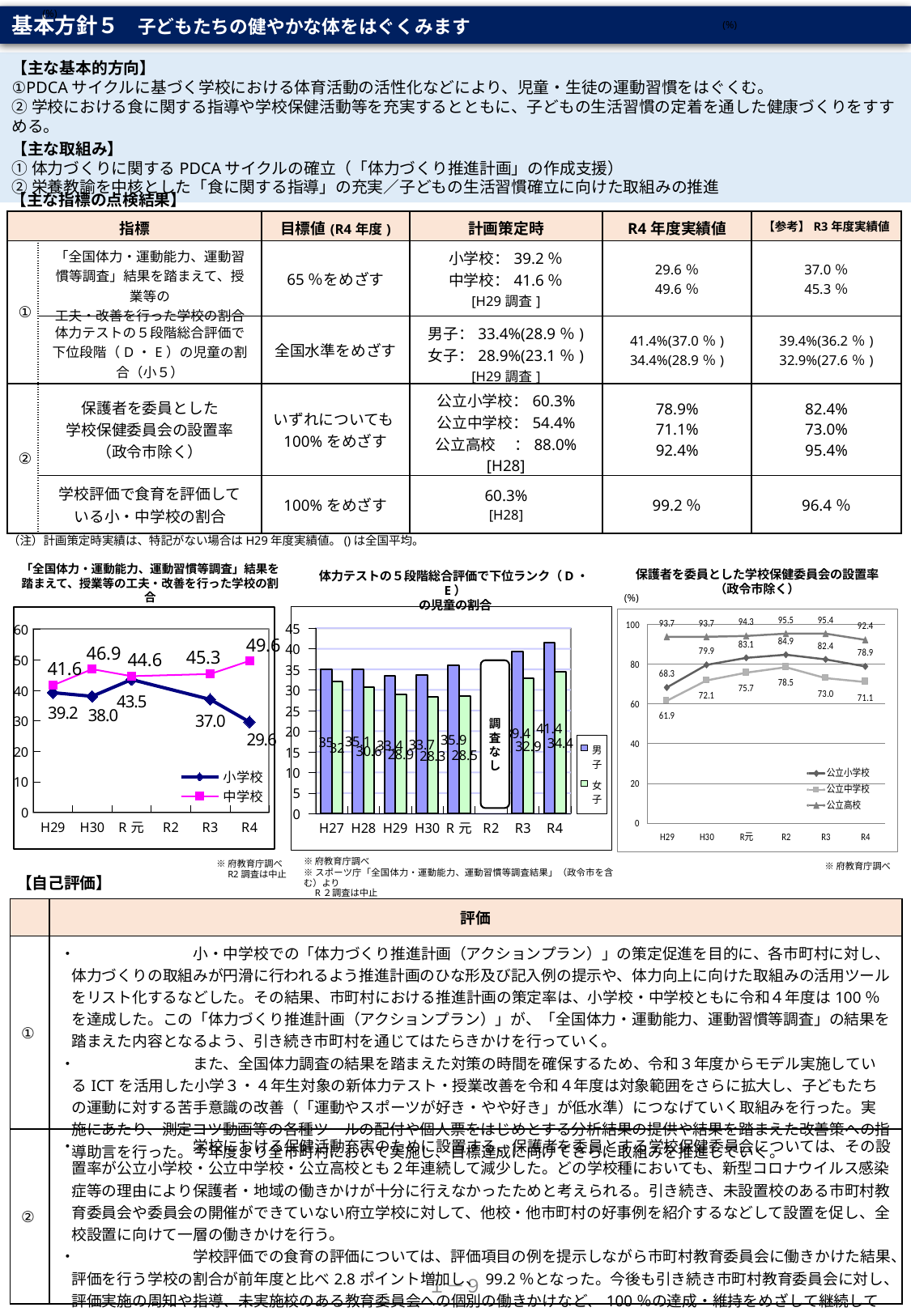
In the middle chart (体力テストの５段階総合評価で下位ランク（D・E）の児童の割合), which is larger in R3, 男子 or 女子? 男子 In the middle chart (体力テストの５段階総合評価で下位ランク（D・E）の児童の割合), what is the value for 男子 in R4? 41.4 In the left chart (「全国体力・運動能力、運動習慣等調査」結果を踏まえて、授業等の工夫・改善を行った学校の割合), how many series does the legend list? 2 In the right chart (保護者を委員とした学校保健委員会の設置率（政令市除く）), which series has the lowest value in H29? 公立中学校 In the middle chart (体力テストの５段階総合評価で下位ランク（D・E）の児童の割合), what is the value for 女子 in H30? 28.3 In the left chart (「全国体力・運動能力、運動習慣等調査」結果を踏まえて、授業等の工夫・改善を行った学校の割合), which year has the highest value for 中学校? R4 In the right chart (保護者を委員とした学校保健委員会の設置率（政令市除く）), what is the value for 公立中学校 in R2? 78.5 In the left chart (「全国体力・運動能力、運動習慣等調査」結果を踏まえて、授業等の工夫・改善を行った学校の割合), what is the value for 中学校 in H30? 46.9 What kind of chart is the middle chart (体力テストの５段階総合評価で下位ランク（D・E）の児童の割合)? Bar chart In the right chart (保護者を委員とした学校保健委員会の設置率（政令市除く）), what is the difference between 公立高校 and 公立小学校 in R4? 13.5 In the left chart (「全国体力・運動能力、運動習慣等調査」結果を踏まえて、授業等の工夫・改善を行った学校の割合), what is the value for 小学校 in R4? 29.6 In the left chart (「全国体力・運動能力、運動習慣等調査」結果を踏まえて、授業等の工夫・改善を行った学校の割合), what is the difference between 中学校 and 小学校 in R4? 20.0